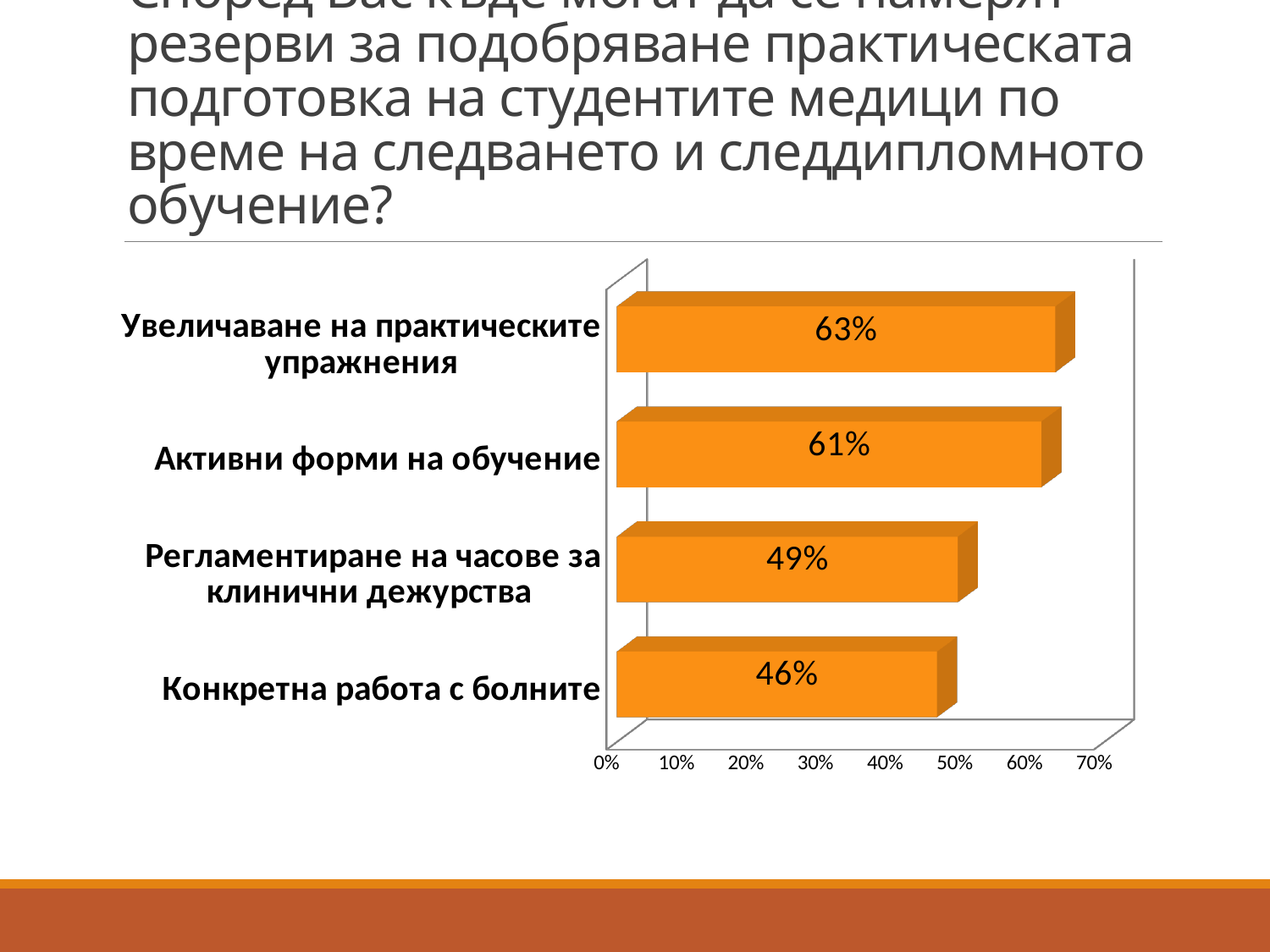
What is the value for "Активни форми на обучение"? 61% What is the difference between the values for "Активни форми на обучение" and "Регламентиране на часове за клинични дежурства"? 12% What kind of chart is shown on the slide? bar chart Which category has the highest value? Увеличаване на практическите упражнения What is the difference between the values for "Увеличаване на практическите упражнения" and "Конкретна работа с болните"? 17% Which category has the lowest value? Конкретна работа с болните What is the value for "Регламентиране на часове за клинични дежурства"? 49% What is the value for "Увеличаване на практическите упражнения"? 63% How many categories are shown in the chart? 4 Is the value for "Активни форми на обучение" greater or less than 50%? greater What is the value for "Конкретна работа с болните"? 46% Which is larger: the value for "Регламентиране на часове за клинични дежурства" or for "Конкретна работа с болните"? Регламентиране на часове за клинични дежурства